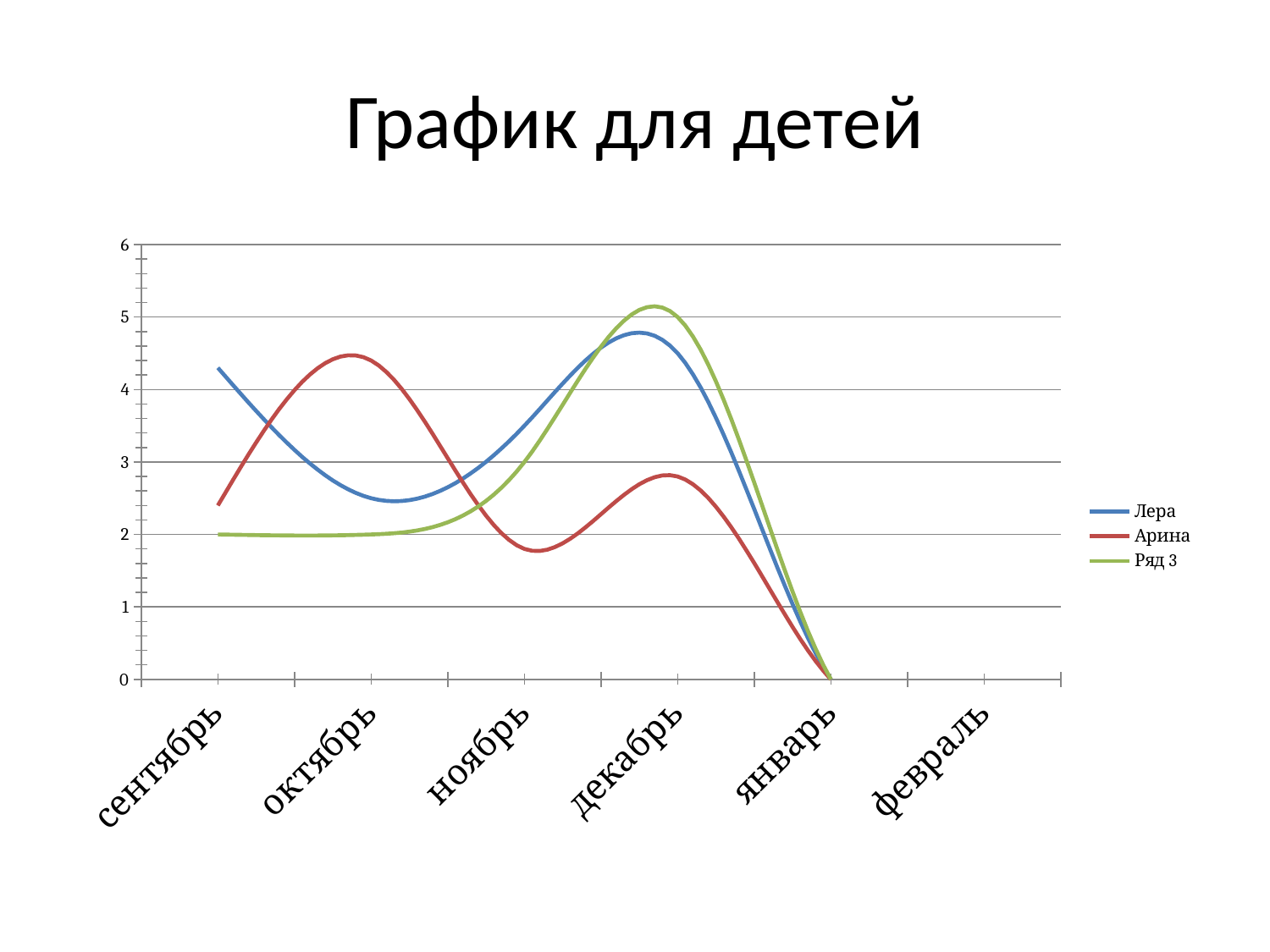
Is the value for Арина in ноябрь greater or less than 2? less Which series has the highest value in декабрь? Ряд 3 Is the value for Лера in сентябрь greater or less than 4? greater What kind of chart is shown on the slide? line chart What is the value for Лера in январь? 0 What is the title of the chart? График для детей In which month does Арина reach its highest value? октябрь How many months are labelled on the x axis? 6 How many series does the legend list? 3 Which series is drawn in red? Арина What is the value for Ряд 3 in сентябрь? 2